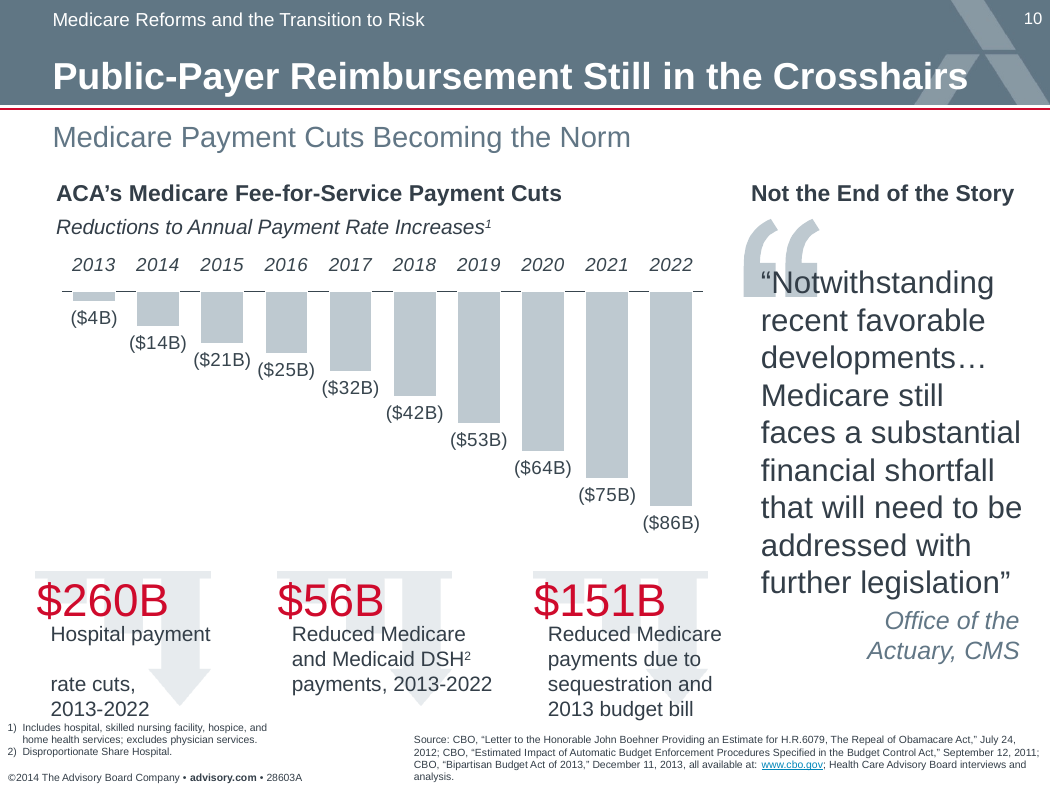
What is the value shown for 2022 in the ACA's Medicare Fee-for-Service Payment Cuts chart? ($86B) What is the value shown for 2013 in the ACA's Medicare Fee-for-Service Payment Cuts chart? ($4B) Which year has the larger reduction in the ACA's Medicare Fee-for-Service Payment Cuts chart, 2019 or 2015? 2019 Which year shows the largest reduction in the ACA's Medicare Fee-for-Service Payment Cuts chart? 2022 What is the difference between the reductions for 2018 and 2017 in the ACA's Medicare Fee-for-Service Payment Cuts chart? $10B What is the value shown for 2018 in the ACA's Medicare Fee-for-Service Payment Cuts chart? ($42B) By how much does the reduction for 2022 exceed the reduction for 2013 in the ACA's Medicare Fee-for-Service Payment Cuts chart? $82B Do the annual reductions in the ACA's Medicare Fee-for-Service Payment Cuts chart get larger or smaller from 2013 to 2022? Larger Which year shows the smallest reduction in the ACA's Medicare Fee-for-Service Payment Cuts chart? 2013 What kind of chart is used to show ACA's Medicare Fee-for-Service Payment Cuts? Bar chart What is the value shown for 2016 in the ACA's Medicare Fee-for-Service Payment Cuts chart? ($25B) How many years are shown in the ACA's Medicare Fee-for-Service Payment Cuts chart? 10